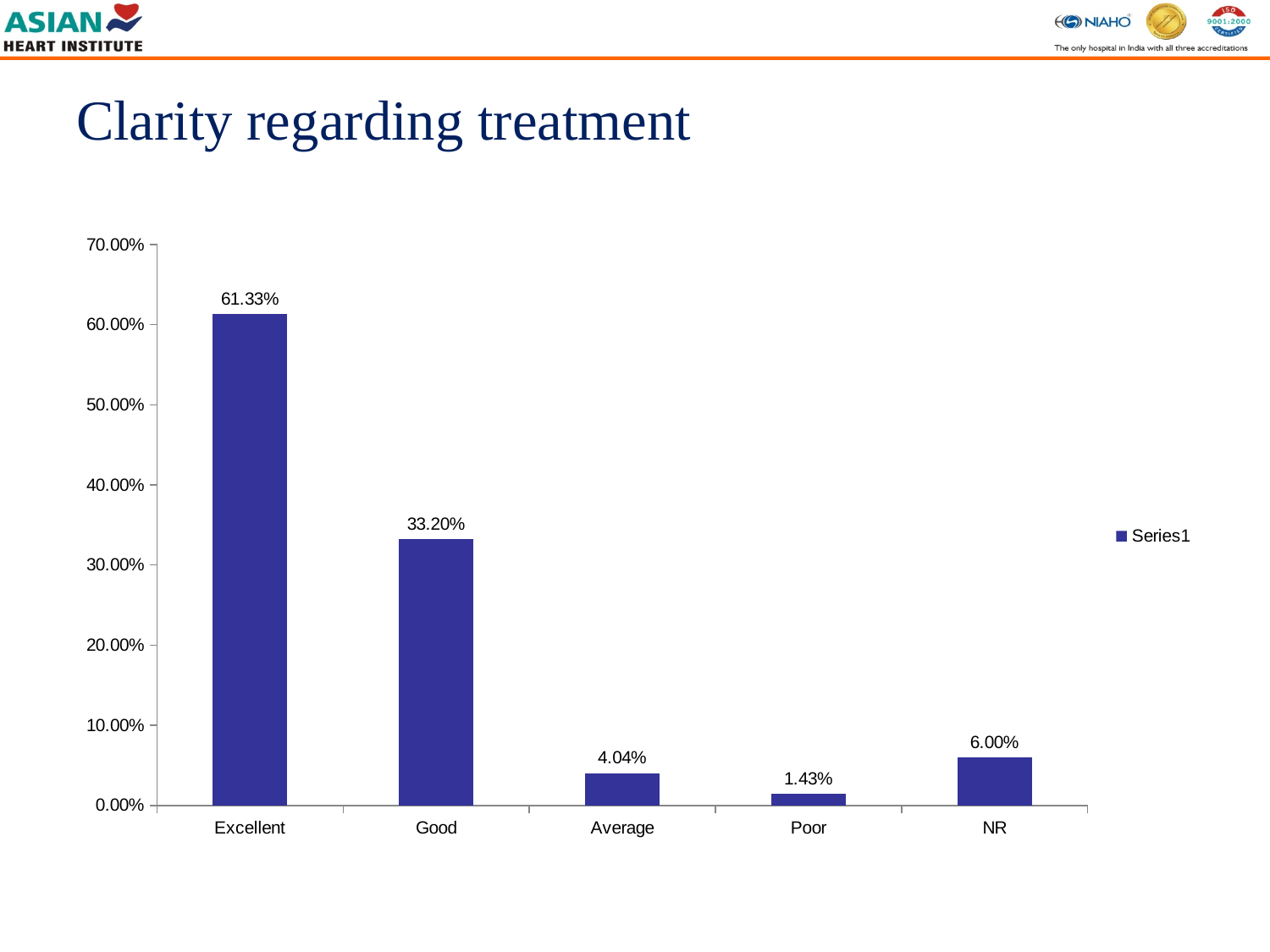
Which category has the lowest value? Poor Is the value for Good greater or less than 30.00%? greater What is the value for NR? 6.00% What kind of chart is shown on the slide? Bar chart How many series does the legend list? 1 What is the title of the slide? Clarity regarding treatment What is the difference between the values for Excellent and Good? 28.13% Which category has the highest value? Excellent What is the value for Good? 33.20% Which is larger, the value for Average or the value for NR? NR What is the value for Excellent? 61.33% How many categories are shown on the x axis? 5